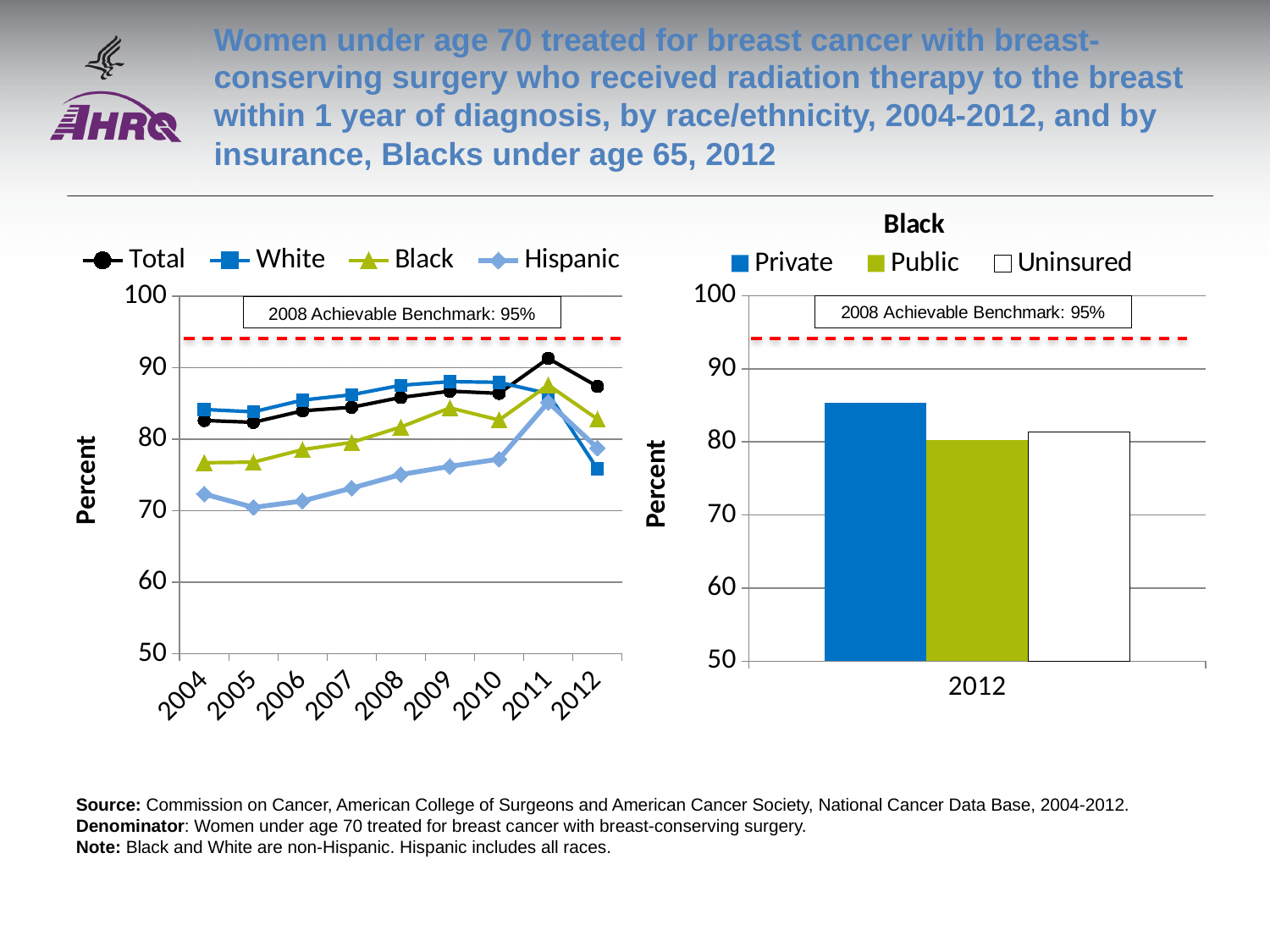
What kind of chart is the right chart titled Black? Bar chart On the left chart, how many series does the legend list? 4 On the left chart, which series has the lowest value in 2004? Hispanic What kind of chart is the left chart? Line chart On the left chart, is the value for Total in 2011 greater or less than 90? greater On the right chart titled Black, is the value for Public greater or less than 90? less On the left chart, how many years are shown on the x axis? 9 What is the 2008 Achievable Benchmark shown on both charts? 95% On the right chart titled Black, how many series does the legend list? 3 On the right chart titled Black, which insurance group has the highest value in 2012? Private On the left chart, is the value for Hispanic in 2004 greater or less than 80? less On the left chart, which series has the highest value in 2011? Total